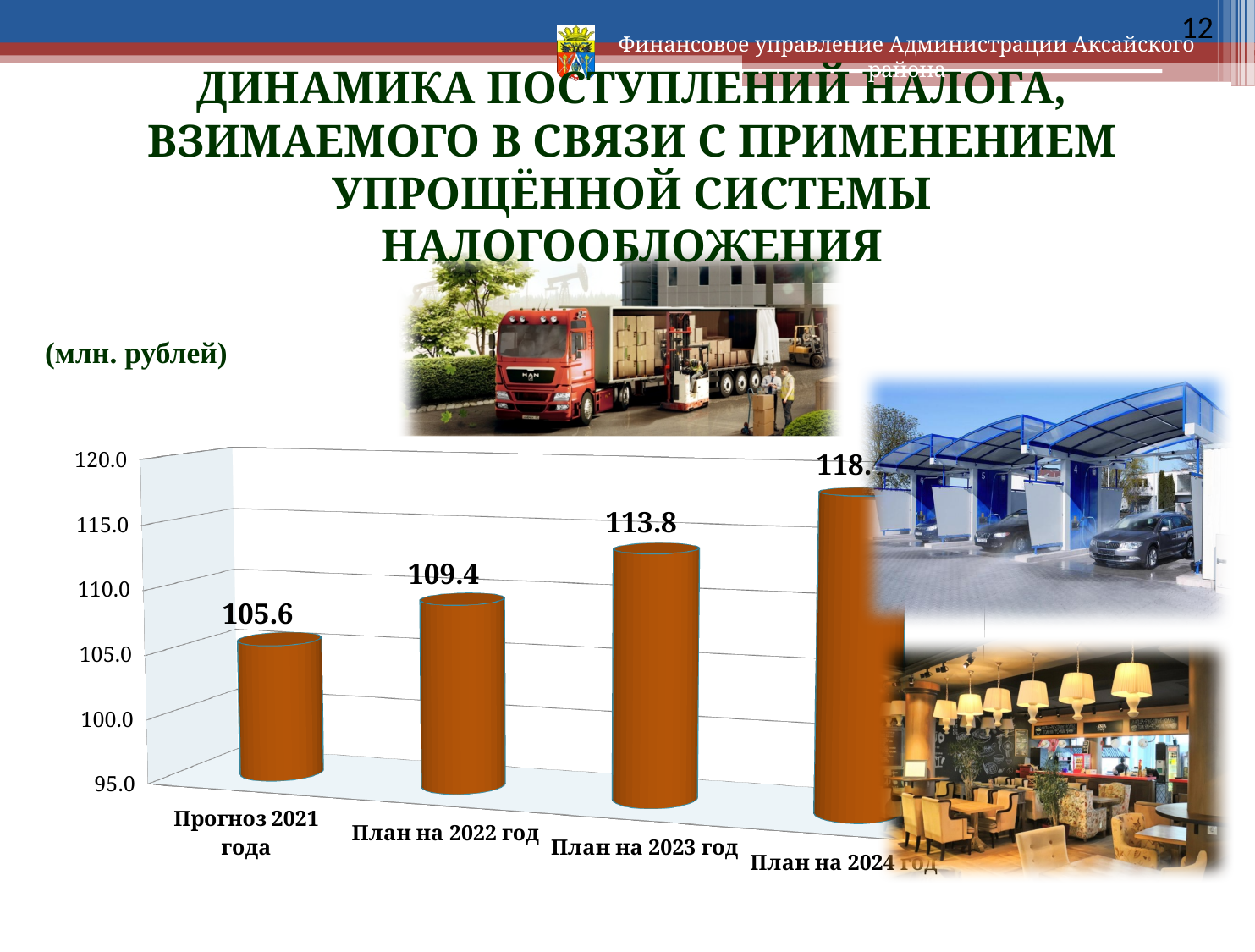
What is the difference between the values for План на 2022 год and Прогноз 2021 года? 3.8 Do the values rise or fall from Прогноз 2021 года to План на 2024 год? rise Is the value for План на 2024 год greater or less than 115.0? greater What is the difference between the values for План на 2023 год and План на 2022 год? 4.4 What kind of chart is shown on the slide? bar chart How many categories are shown on the x axis? 4 Which is larger, the value for План на 2023 год or the value for План на 2022 год? План на 2023 год What is the value for План на 2022 год? 109.4 What is the value for Прогноз 2021 года? 105.6 Which category has the highest value? План на 2024 год Which category has the lowest value? Прогноз 2021 года What is the value for План на 2023 год? 113.8